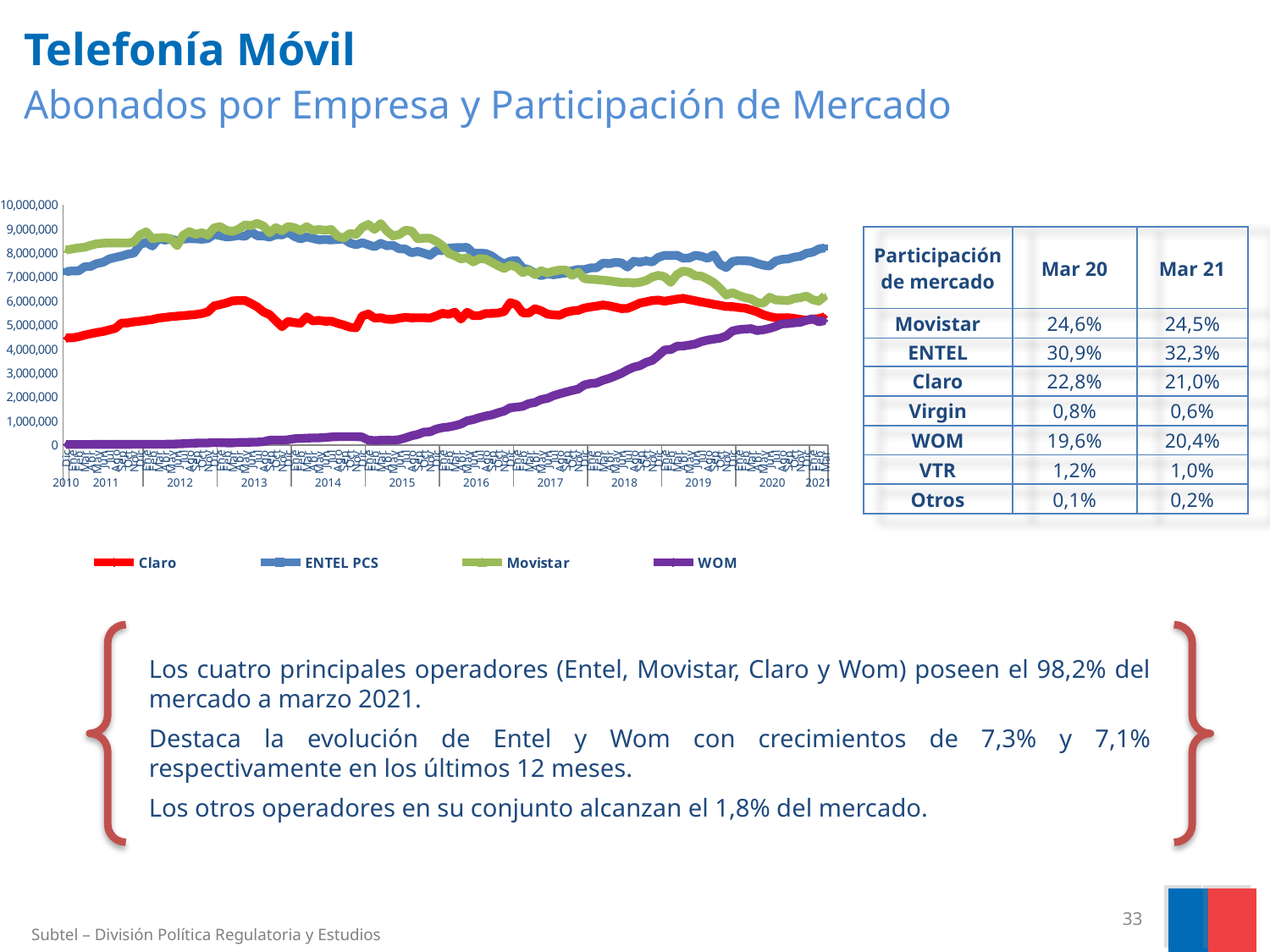
What colour is the WOM line in the chart? purple Which series has the highest number of subscribers at the end of the chart in 2021? ENTEL PCS How many series does the chart legend list? 4 Is the value for WOM in 2015 greater or less than 1,000,000? less Which series has the highest number of subscribers in 2015? Movistar Which series has the lowest number of subscribers in 2010? WOM Is the value for ENTEL PCS in 2021 greater or less than 7,000,000? greater What kind of chart is shown on the slide? line chart In 2021, which series has more subscribers, Movistar or ENTEL PCS? ENTEL PCS Is the value for Movistar in 2013 greater or less than 8,000,000? greater In 2018, which series has more subscribers, Claro or WOM? Claro Does the WOM series rise or fall along the x axis from 2015 to 2021? rise